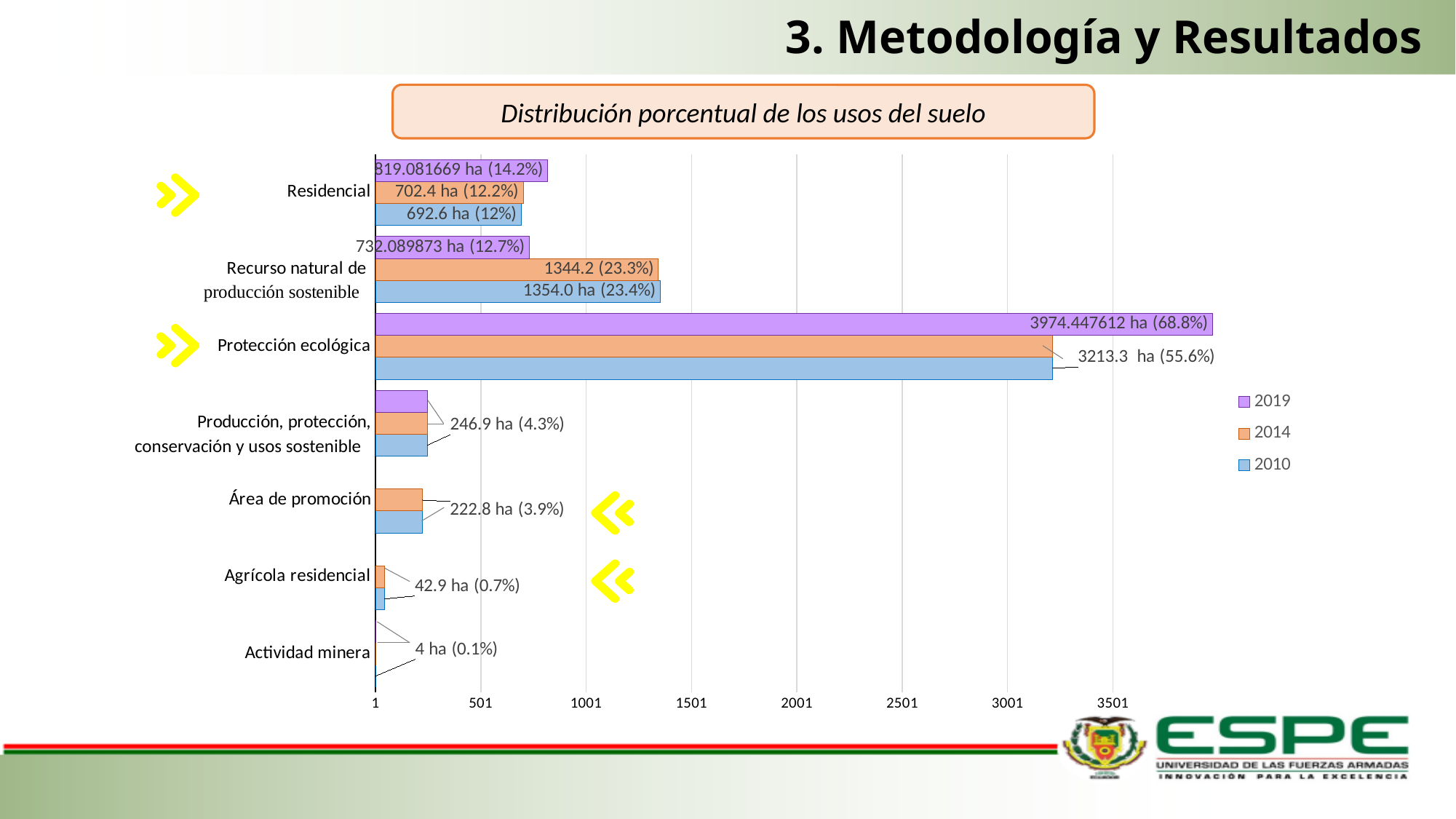
What is the 2014 value for Recurso natural de producción sostenible? 1344.2 (23.3%) What is the 2019 value for Protección ecológica? 3974.447612 ha (68.8%) For Residencial, which is larger: the 2014 value or the 2010 value? 2014 Is the 2010 value for Protección ecológica greater or less than 3001? greater What is the difference in hectares between the 2014 and 2010 values for Residencial? 9.8 ha How many series does the legend list? 3 What is the 2010 value for Residencial? 692.6 ha (12%) What is the 2019 value for Residencial? 819.081669 ha (14.2%) How many land-use categories are shown on the y axis? 7 Which category has the longest 2019 bar? Protección ecológica What is the 2010 value for Recurso natural de producción sostenible? 1354.0 ha (23.4%) What kind of chart is shown on the slide? bar chart